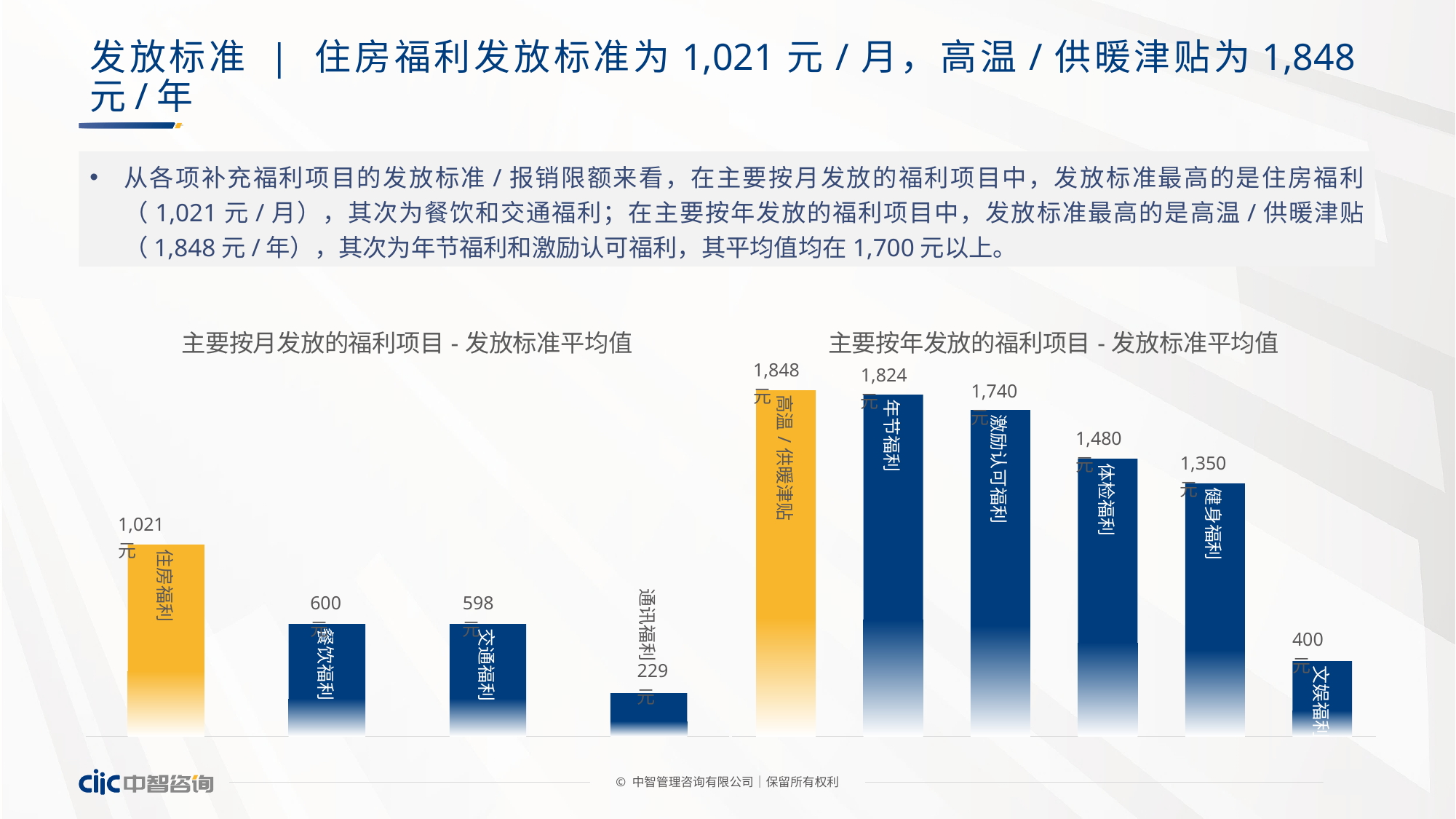
In the chart titled 主要按年发放的福利项目 - 发放标准平均值, which category has the highest value? 高温 / 供暖津贴 In the chart titled 主要按月发放的福利项目 - 发放标准平均值, how many categories are shown? 4 In the chart titled 主要按月发放的福利项目 - 发放标准平均值, which category has the lowest value? 通讯福利 In the chart titled 主要按年发放的福利项目 - 发放标准平均值, what is the value for 激励认可福利? 1,740 元 In the chart titled 主要按年发放的福利项目 - 发放标准平均值, what is the value for 健身福利? 1,350 元 In the chart titled 主要按月发放的福利项目 - 发放标准平均值, what is the difference between 住房福利 and 餐饮福利? 421 元 What kind of chart is the chart titled 主要按年发放的福利项目 - 发放标准平均值? Bar chart In the chart titled 主要按年发放的福利项目 - 发放标准平均值, which category has the lowest value? 文娱福利 In the chart titled 主要按月发放的福利项目 - 发放标准平均值, what is the value for 住房福利? 1,021 元 In the chart titled 主要按年发放的福利项目 - 发放标准平均值, which is larger, 体检福利 or 文娱福利? 体检福利 In the chart titled 主要按年发放的福利项目 - 发放标准平均值, what is the difference between 高温 / 供暖津贴 and 体检福利? 368 元 In the chart titled 主要按月发放的福利项目 - 发放标准平均值, what is the value for 通讯福利? 229 元